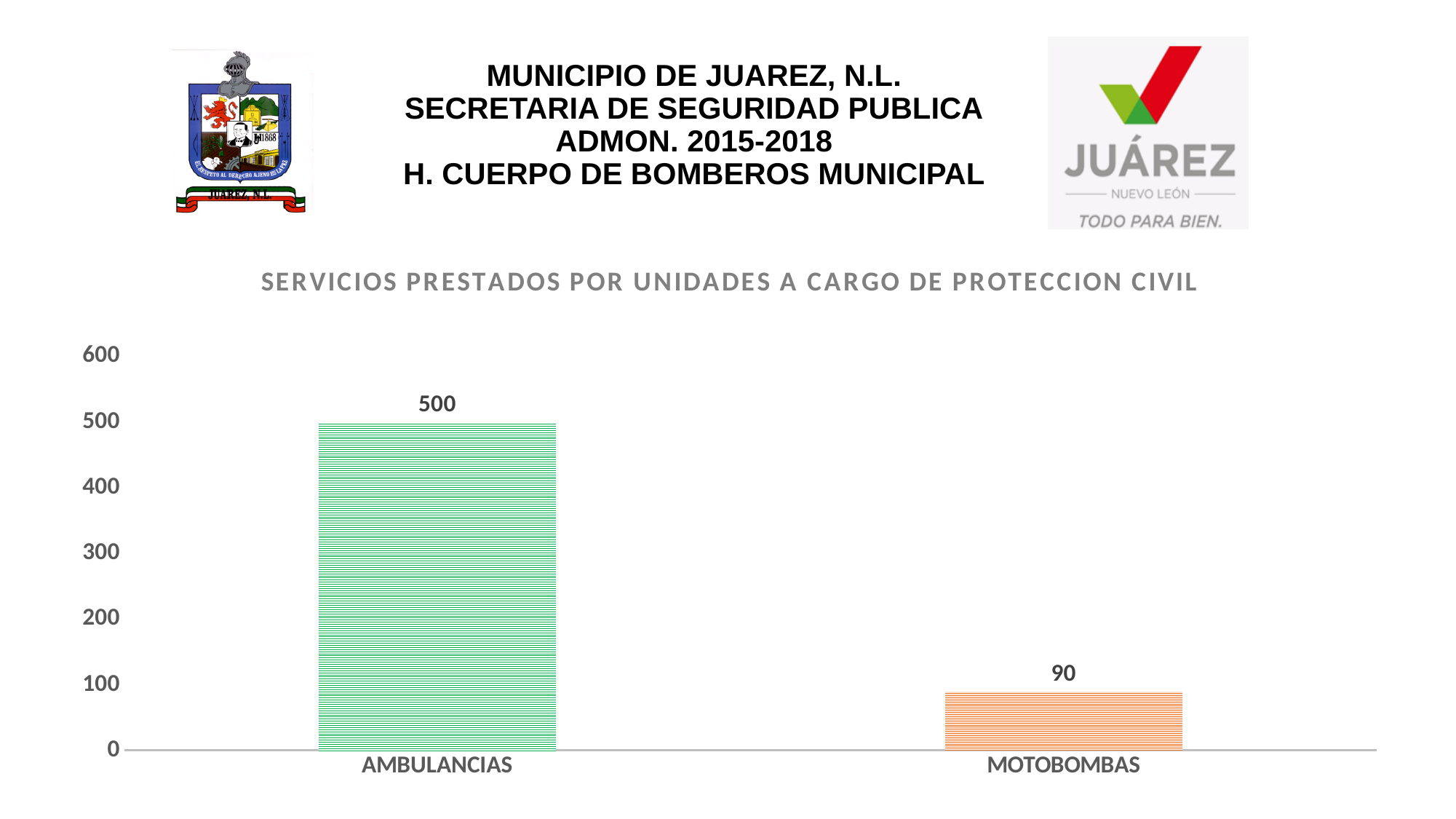
Which category has the highest value? AMBULANCIAS What is the title of the chart? SERVICIOS PRESTADOS POR UNIDADES A CARGO DE PROTECCION CIVIL What is the value for AMBULANCIAS? 500 What is the value for MOTOBOMBAS? 90 What colour is the bar for MOTOBOMBAS? orange Which category has the lowest value? MOTOBOMBAS What kind of chart is shown on the slide? bar chart Is the value for MOTOBOMBAS greater or less than 100? less How many categories are shown on the chart? 2 What is the difference between the values for AMBULANCIAS and MOTOBOMBAS? 410 Is the value for AMBULANCIAS greater or less than 400? greater Which is larger, the value for AMBULANCIAS or the value for MOTOBOMBAS? AMBULANCIAS